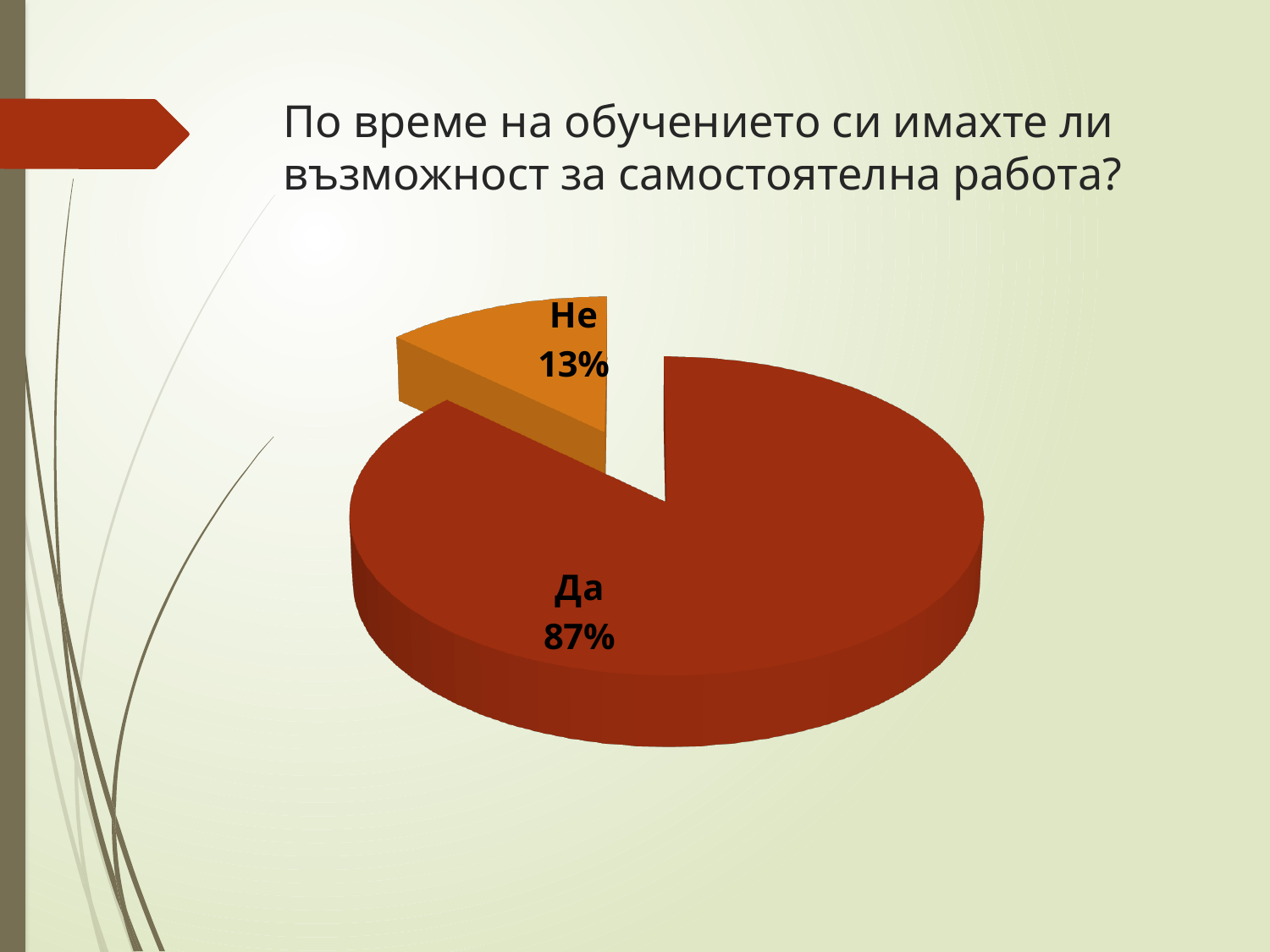
What colour is the "Не" slice of the pie chart? orange What share of the pie does the "Да" slice represent? 87% Which is larger, the "Да" slice or the "Не" slice? Да Which slice of the pie is the largest? Да What kind of chart is shown on the slide? pie chart What is the difference in percentage points between the "Да" and "Не" slices? 74 What share of the pie does the "Не" slice represent? 13% What is the title of the slide containing the pie chart? По време на обучението си имахте ли възможност за самостоятелна работа? Which slice of the pie is the smallest? Не How many slices does the pie chart have? 2